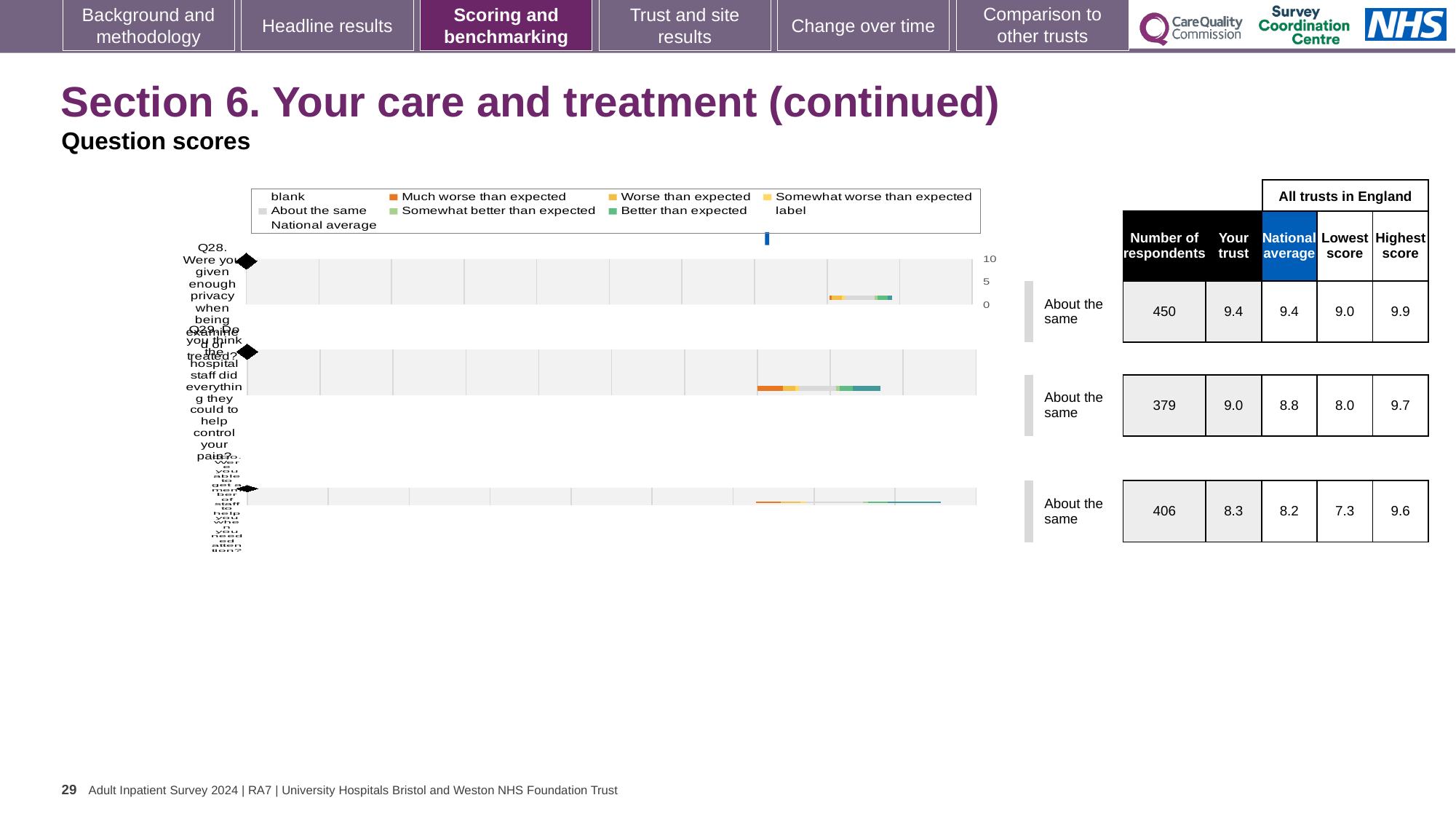
What kind of chart is used to show the question scores on this slide? bar chart Which question has the lowest 'Your trust' score? Q30 What is the lowest score among all trusts in England for Q30? 7.3 How many questions (rows) are plotted in the question scores chart? 3 For Q29, how much higher is the 'Your trust' score than the national average? 0.2 What is the 'Your trust' score for Q28? 9.4 What benchmark category is shown for Q29? About the same For Q30, which is larger: the 'Your trust' score or the national average? Your trust What is the national average score for Q29 (staff did everything to help control pain)? 8.8 What is the highest score among all trusts in England for Q30? 9.6 How many respondents are listed for Q28 (privacy when being examined or treated)? 450 Which question has the highest 'Your trust' score? Q28